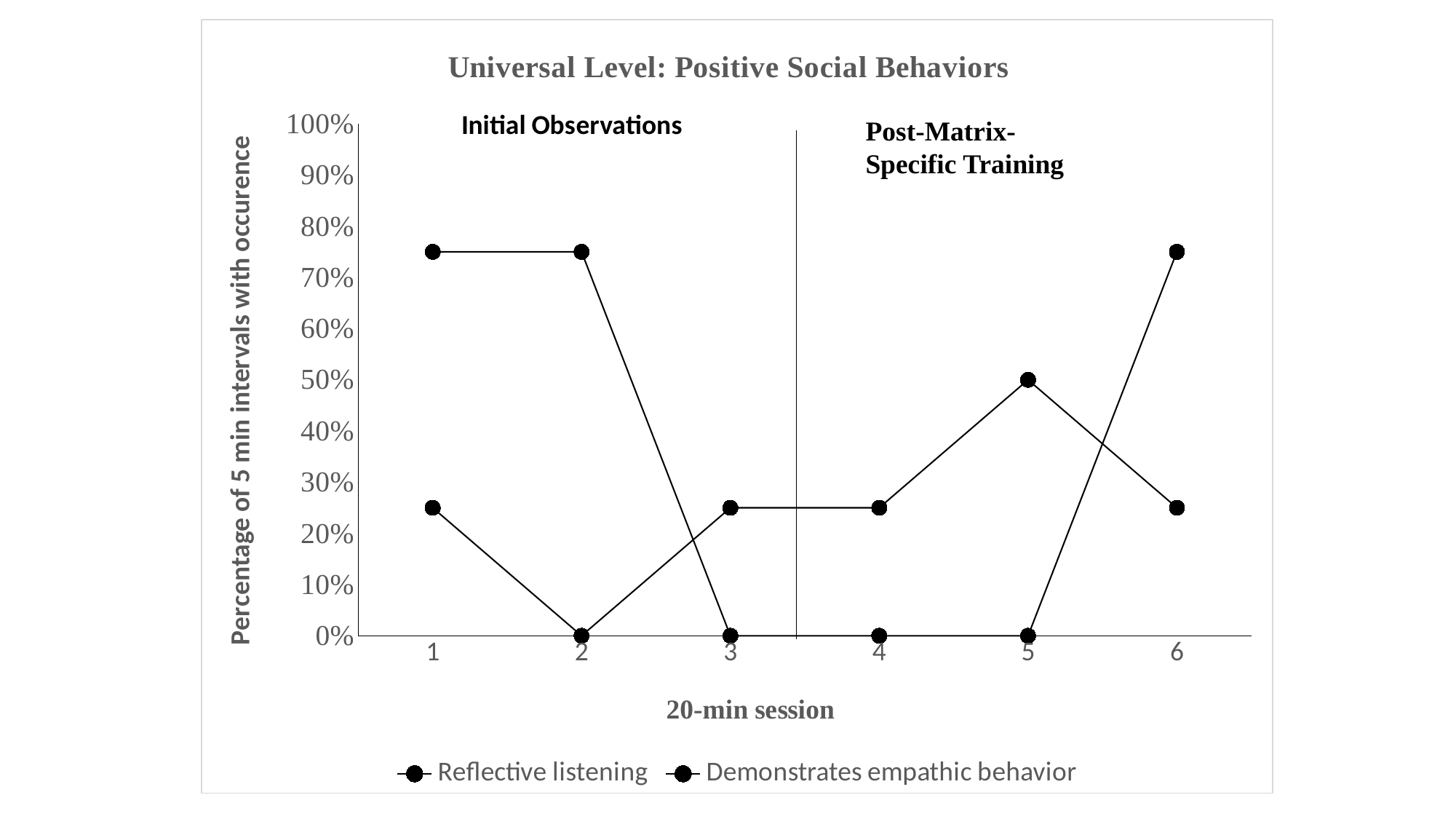
At session 1, is the higher of the two plotted values greater or less than 70%? greater At session 6, is the lower of the two plotted values greater or less than 30%? less At session 3, what is the lower of the two plotted values? 0% At session 5, what is the higher of the two plotted values? 50% How many 20-min sessions are plotted along the x axis? 6 At session 2, is the higher of the two plotted values greater or less than 70%? greater How many series does the legend list? 2 What is the title of the chart? Universal Level: Positive Social Behaviors At session 4, what is the lower of the two plotted values? 0% What are the two series named in the legend? Reflective listening; Demonstrates empathic behavior How many plotted points across the chart sit at 0%? 4 What kind of chart is shown on the slide? line chart